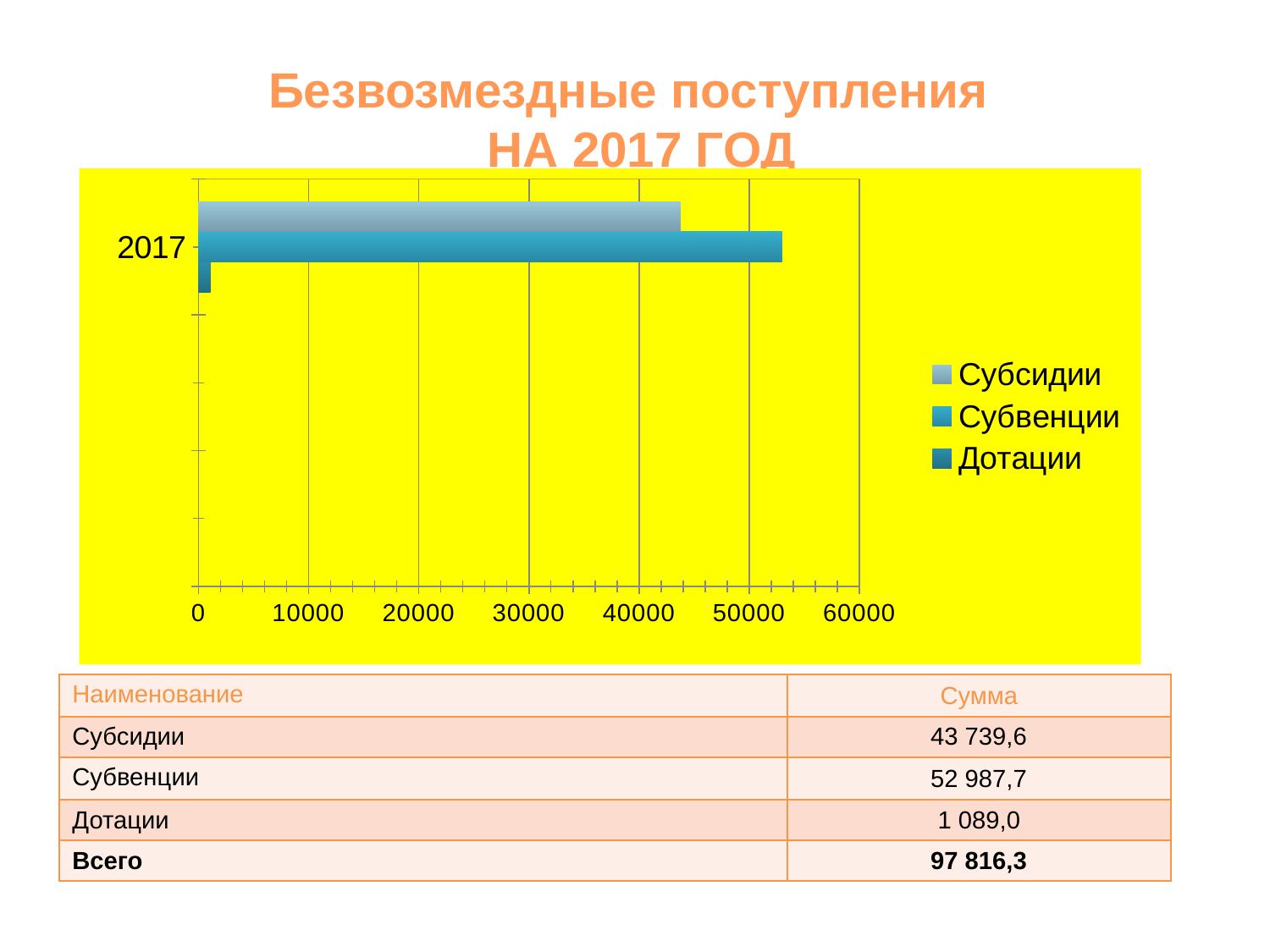
What year label is shown on the category axis of the chart? 2017 Which series has the shortest bar in the chart? Дотации Is the value for Дотации greater or less than 10000? less Is the value for Субвенции greater or less than 50000? greater What is the value for Субсидии according to the slide? 43 739,6 What is the total (Всего) of the three series shown on the slide? 97 816,3 What is the value for Дотации according to the slide? 1 089,0 Which series has the longest bar in the chart? Субвенции Is the value for Субсидии greater or less than 50000? less What kind of chart is shown on the slide? bar chart How many series does the chart legend list? 3 Which is larger, the bar for Субсидии or the bar for Субвенции? Субвенции